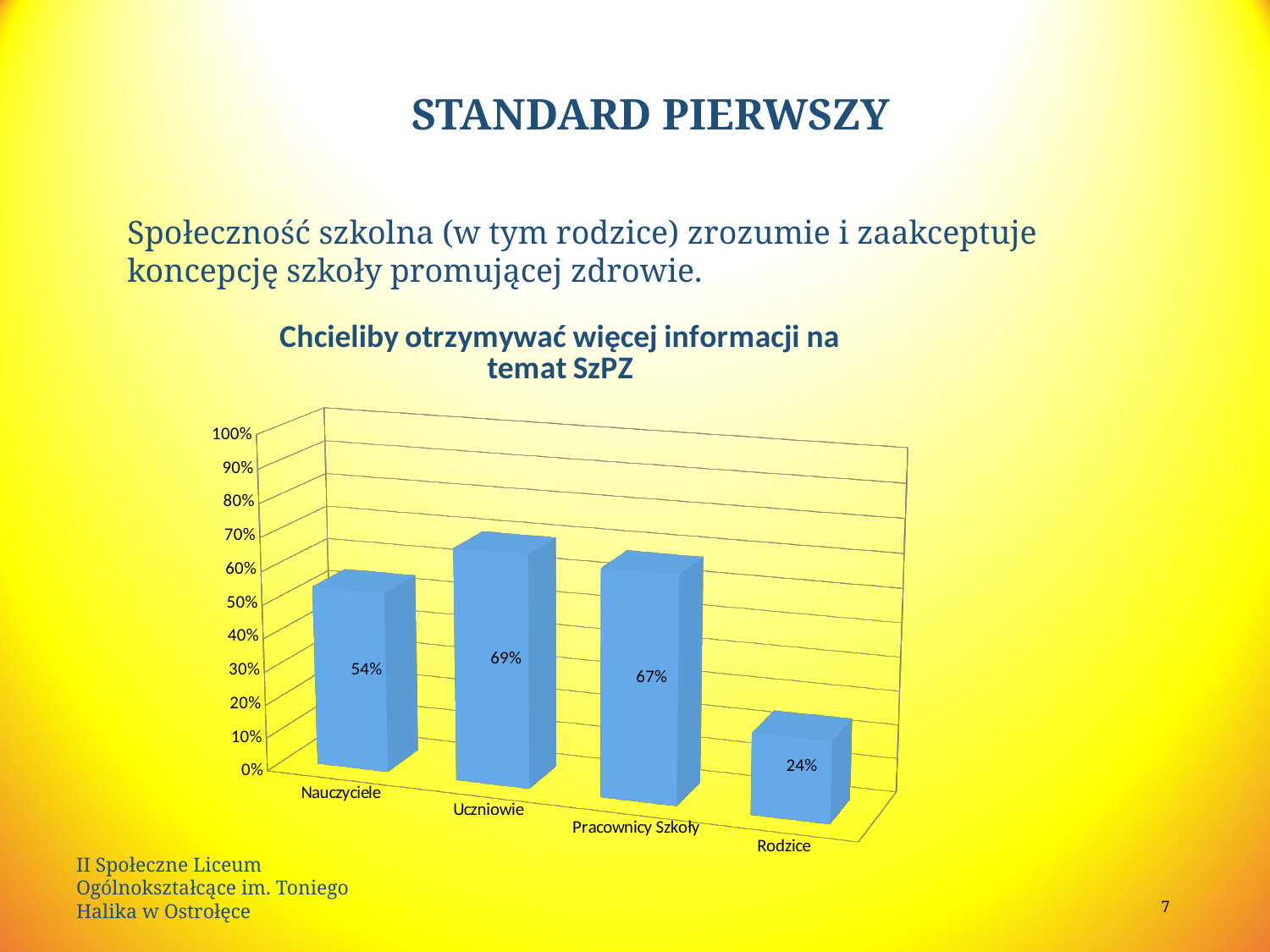
What is the value for Pracownicy Szkoły? 67% What is the value for Rodzice? 24% What kind of chart is shown on the slide? Bar chart What is the value for Nauczyciele? 54% Which category has the highest value? Uczniowie What is the title of the chart? Chcieliby otrzymywać więcej informacji na temat SzPZ What is the difference between the values for Pracownicy Szkoły and Nauczyciele? 13% Which is larger, the value for Nauczyciele or the value for Rodzice? Nauczyciele What is the difference between the values for Uczniowie and Rodzice? 45% How many categories are shown in the chart? 4 Which category has the lowest value? Rodzice What is the value for Uczniowie? 69%